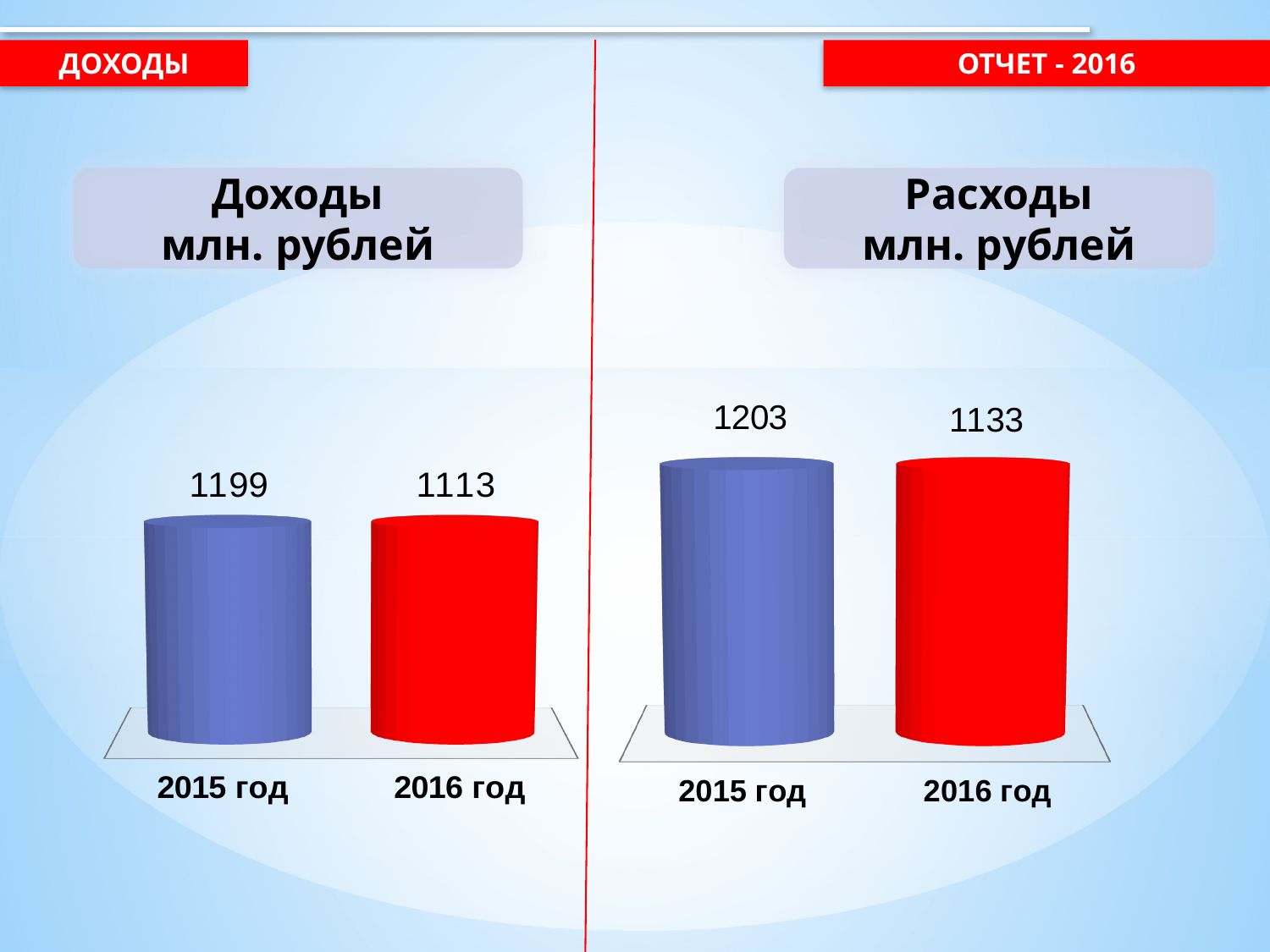
In the 'Расходы млн. рублей' chart, what is the difference between the 2015 год and 2016 год values? 70 In the 'Расходы млн. рублей' chart, which year has the lower value? 2016 год In the 'Расходы млн. рублей' chart, is the value for 2015 год larger or smaller than the value for 2016 год? larger In the 'Расходы млн. рублей' chart, what is the value for 2016 год? 1133 In the 'Доходы млн. рублей' chart, what is the value for 2016 год? 1113 In the 'Доходы млн. рублей' chart, which year has the higher value? 2015 год In the 'Доходы млн. рублей' chart, what is the difference between the 2015 год and 2016 год values? 86 In the 'Расходы млн. рублей' chart, what is the value for 2015 год? 1203 In the 'Доходы млн. рублей' chart, do the values rise or fall from 2015 год to 2016 год? fall What type of chart is the 'Расходы млн. рублей' chart? bar chart In the 'Доходы млн. рублей' chart, what is the value for 2015 год? 1199 How many categories are shown in the 'Доходы млн. рублей' chart? 2